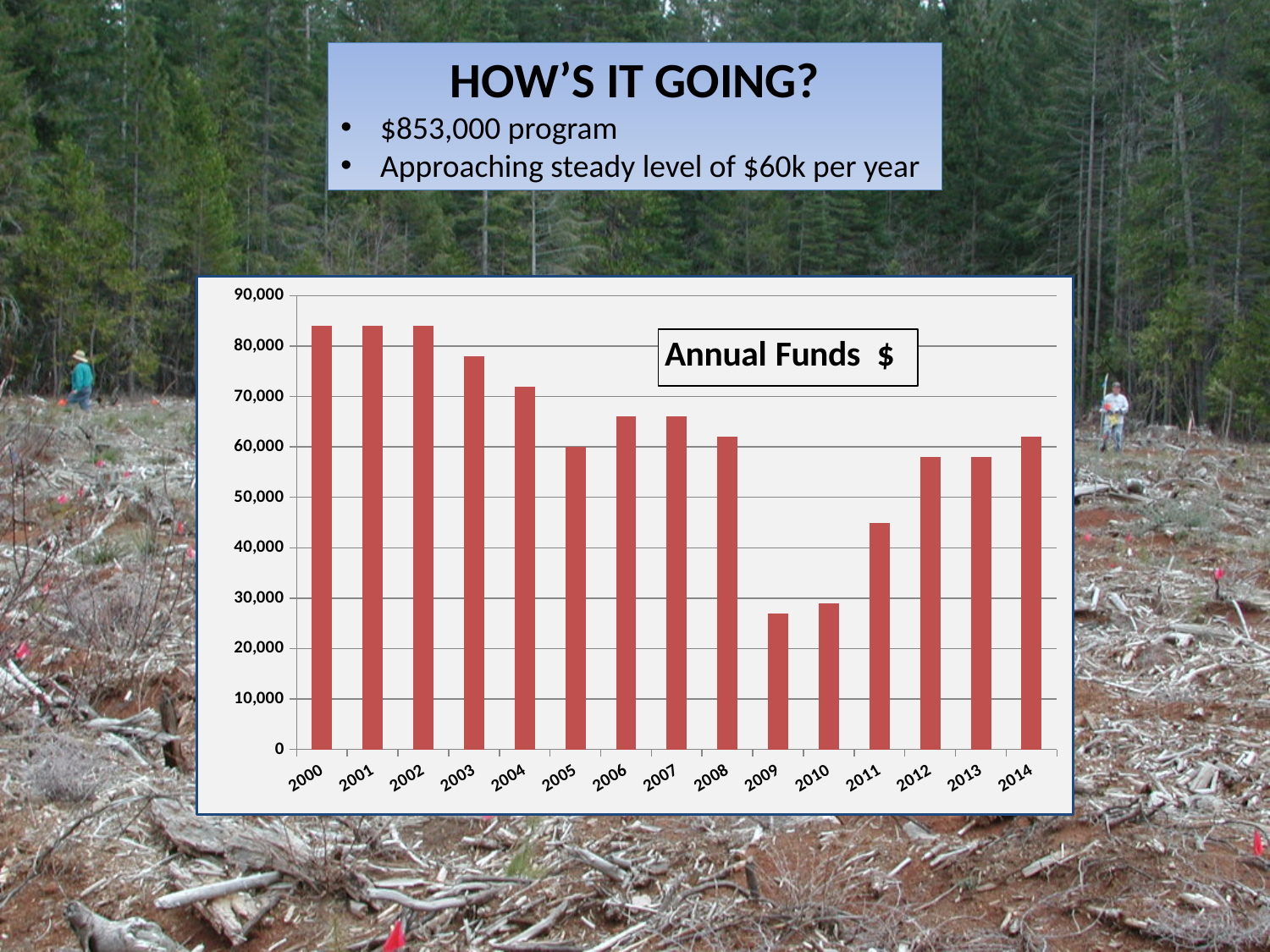
Is the value for 2011 greater or less than 50,000? less What is the title of the chart? Annual Funds $ Is the value for 2004 greater or less than 70,000? greater Which year has the lowest annual funds? 2009 Is the value for 2000 greater or less than 80,000? greater What kind of chart is shown on the slide? bar chart Do the annual funds generally rise or fall from 2000 to 2009? fall Which year has the larger value, 2011 or 2012? 2012 Which year has the larger value, 2000 or 2009? 2000 How many years are plotted on the x axis of the Annual Funds chart? 15